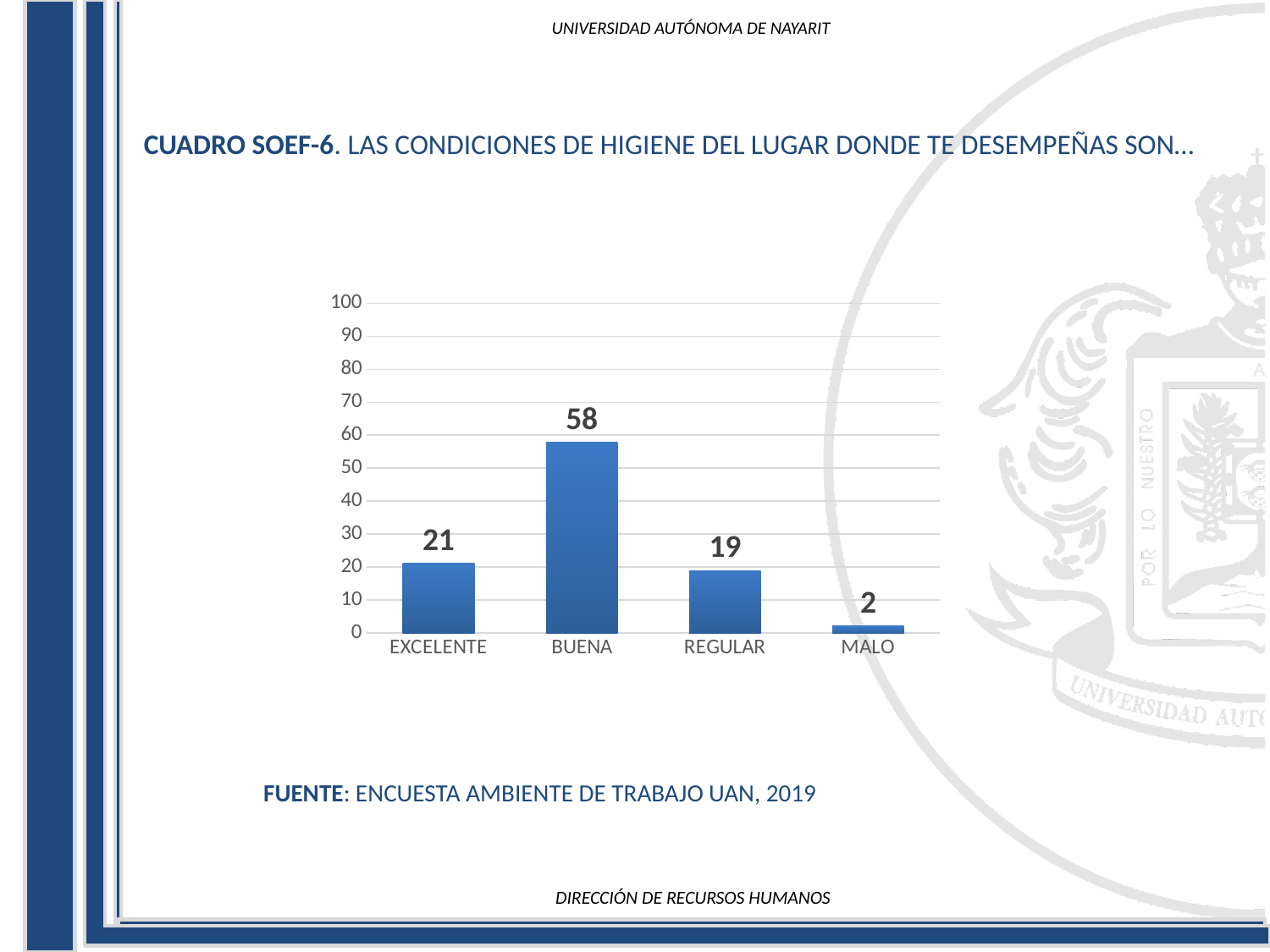
Which category has the highest value? BUENA What kind of chart is shown on the slide? bar chart What is the difference between the values for BUENA and EXCELENTE? 37 What is the value for REGULAR? 19 What is the value for MALO? 2 Which category has the lowest value? MALO What is the difference between the values for EXCELENTE and REGULAR? 2 Is the value for BUENA greater or less than 50? greater What is the value for BUENA? 58 Which is larger, the value for EXCELENTE or the value for REGULAR? EXCELENTE What is the value for EXCELENTE? 21 How many categories are shown on the x axis? 4